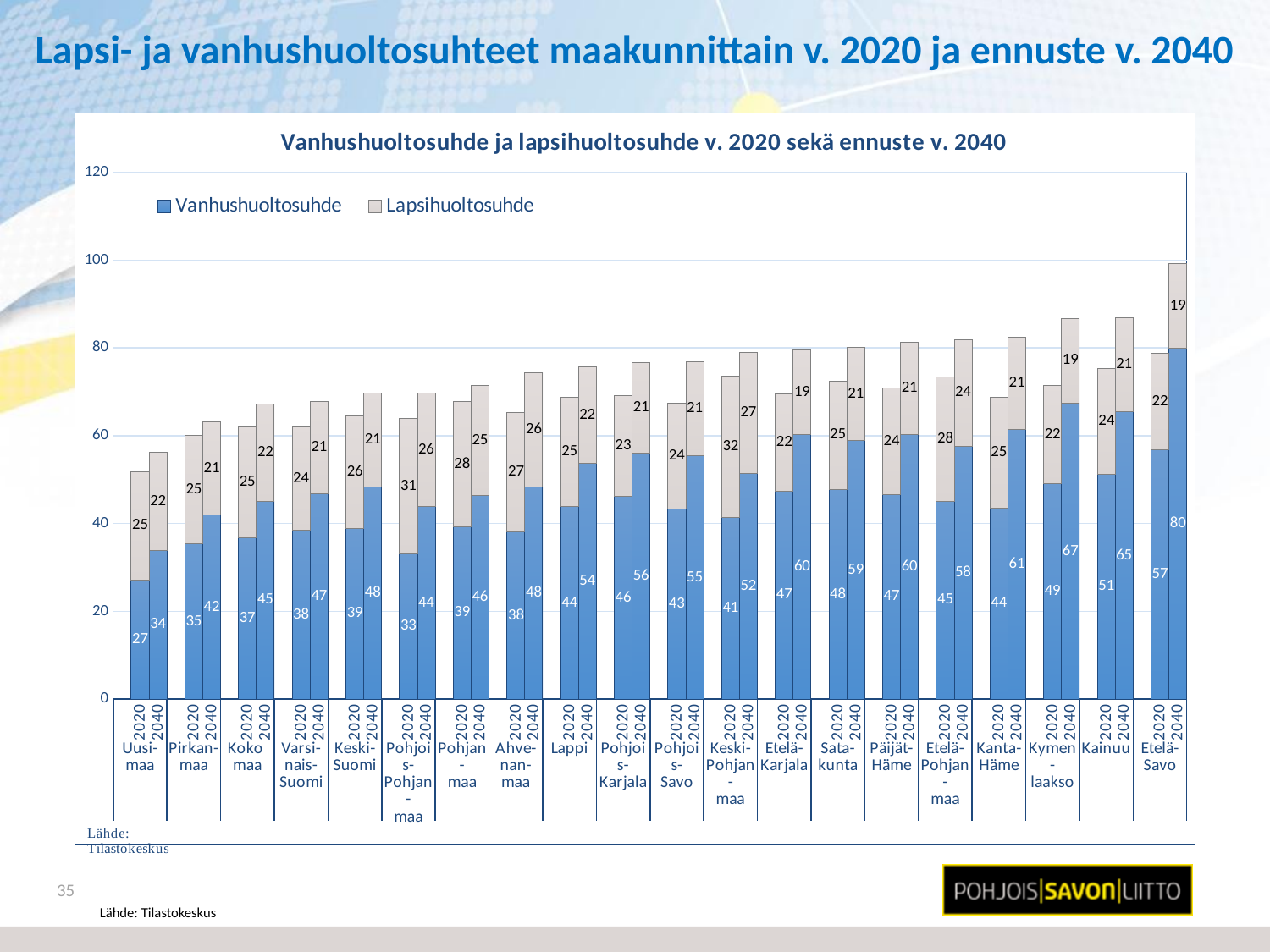
What type of chart is shown on the slide? stacked bar chart What is the total of the stacked bar for Etelä-Savo in 2040? 99 Which is larger: the Vanhushuoltosuhde for Lappi in 2040 or for Pohjanmaa in 2040? Lappi 2040 What is the difference between the Vanhushuoltosuhde values for Kymenlaakso in 2040 and in 2020? 18 What is the Lapsihuoltosuhde value for Keski-Pohjanmaa in 2020? 32 How many regions (categories) are shown on the x axis? 20 What is the Vanhushuoltosuhde value for Uusimaa in 2020? 27 How many series does the chart legend list? 2 Which region and year has the lowest Vanhushuoltosuhde value? Uusimaa 2020 Which region and year has the highest Vanhushuoltosuhde value? Etelä-Savo 2040 What is the Vanhushuoltosuhde value for Etelä-Savo in 2040? 80 What is the title of the chart? Vanhushuoltosuhde ja lapsihuoltosuhde v. 2020 sekä ennuste v. 2040